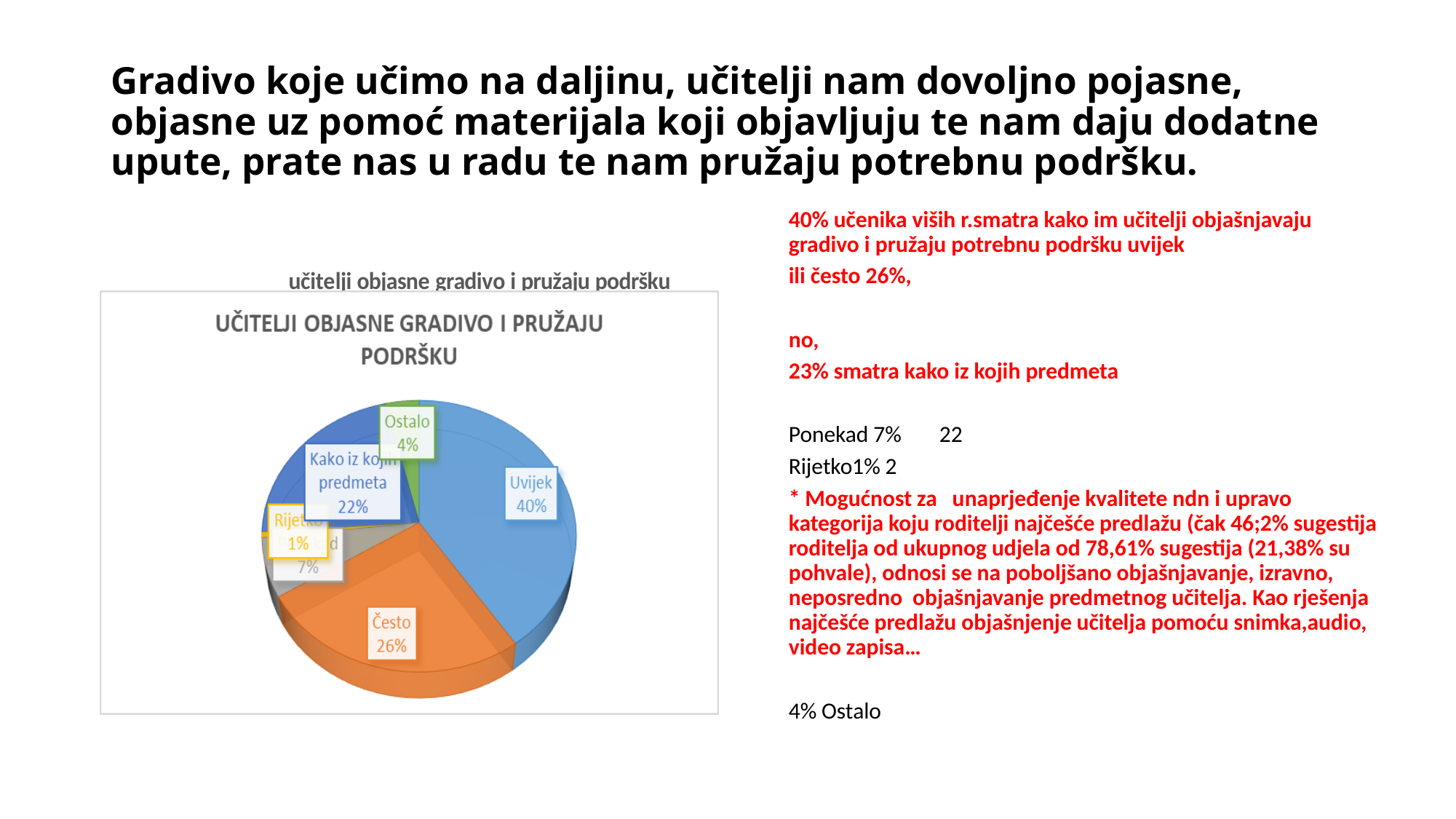
Which category has the largest slice in the pie chart? Uvijek What percentage does the 'Uvijek' slice show in the pie chart? 40% What kind of chart is shown on the slide? pie chart What is the title of the pie chart? UČITELJI OBJASNE GRADIVO I PRUŽAJU PODRŠKU What is the difference in percentage points between the 'Uvijek' and 'Često' slices? 14% What percentage does the 'Često' slice show in the pie chart? 26% What percentage does the 'Rijetko' slice show in the pie chart? 1% Which category has the smallest slice in the pie chart? Rijetko How many slices does the pie chart have? 6 Which slice is larger, 'Često' or 'Kako iz kojih predmeta'? Često What percentage does the 'Kako iz kojih predmeta' slice show in the pie chart? 22% What percentage does the 'Ostalo' slice show in the pie chart? 4%